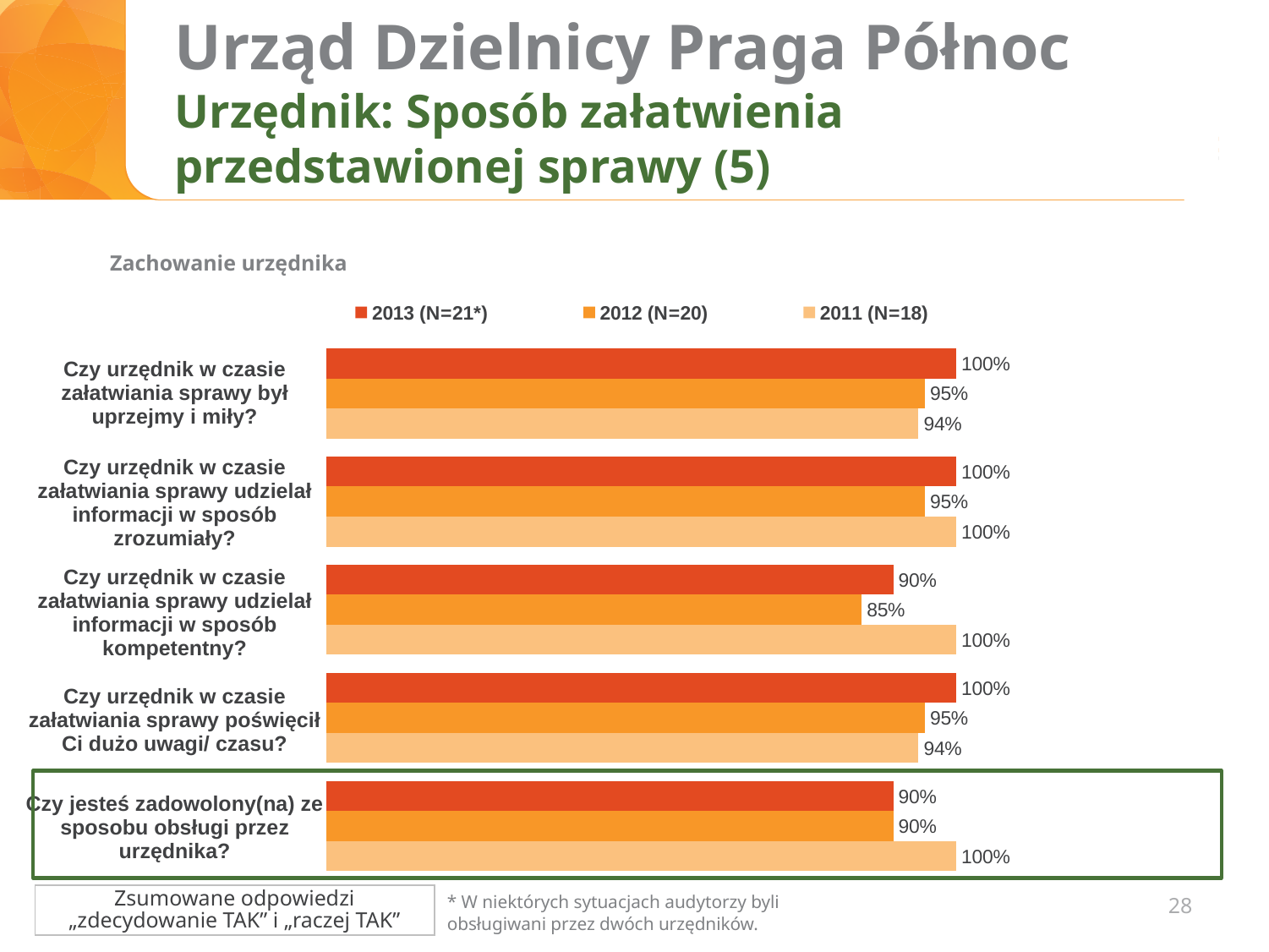
What is the difference between the 2013 and 2012 values for "Czy urzędnik w czasie załatwiania sprawy poświęcił Ci dużo uwagi/ czasu?"? 5% Which year has the lowest value for "Czy urzędnik w czasie załatwiania sprawy udzielał informacji w sposób kompetentny?"? 2012 (N=20) What is the 2011 (N=18) value for "Czy urzędnik w czasie załatwiania sprawy poświęcił Ci dużo uwagi/ czasu?"? 94% What is the 2013 (N=21*) value for "Czy urzędnik w czasie załatwiania sprawy był uprzejmy i miły?"? 100% What is the 2012 (N=20) value for "Czy urzędnik w czasie załatwiania sprawy udzielał informacji w sposób kompetentny?"? 85% For "Czy urzędnik w czasie załatwiania sprawy był uprzejmy i miły?", which is larger: the 2013 value or the 2011 value? 2013 (N=21*) How many series does the legend list? 3 What is the title shown above the chart? Zachowanie urzędnika What type of chart is shown on the slide? bar chart What is the 2011 (N=18) value for "Czy jesteś zadowolony(na) ze sposobu obsługi przez urzędnika?"? 100% How many question categories are shown on the chart? 5 What is the difference between the 2011 and 2012 values for "Czy urzędnik w czasie załatwiania sprawy udzielał informacji w sposób kompetentny?"? 15%